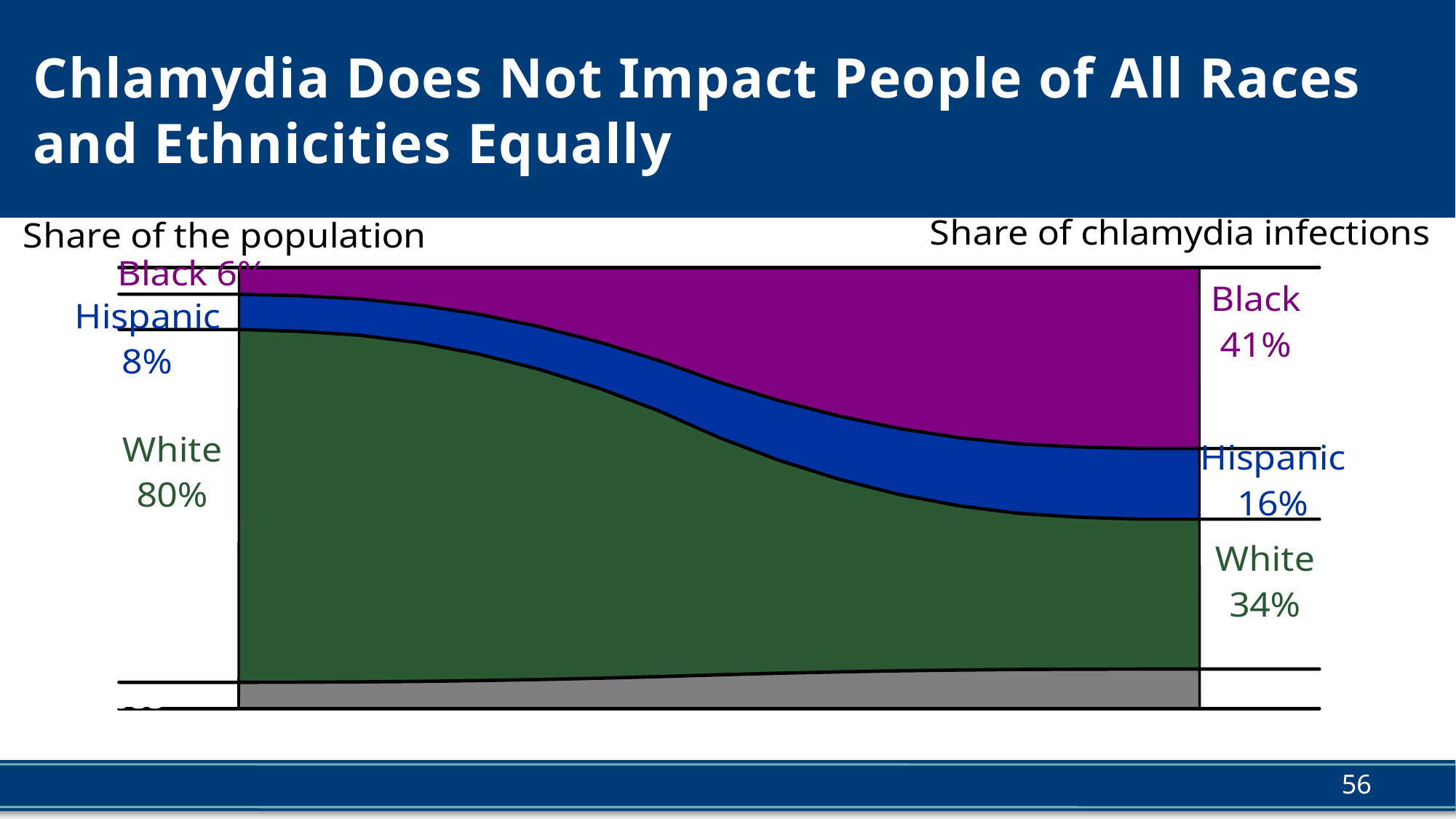
Is the White share larger for the population or for chlamydia infections? Population What is the label above the right side of the chart? Share of chlamydia infections Which labelled group has the largest share of the population? White What is the Hispanic share of chlamydia infections? 16% What is the Black share of chlamydia infections shown on the right side of the chart? 41% Does the White band rise or fall from the population side to the chlamydia infections side? Fall By how many percentage points does the Black share of chlamydia infections exceed the Black share of the population? 35 percentage points What is the White share of chlamydia infections? 34% Which labelled group has the largest share of chlamydia infections? Black What is the White share of the population shown on the left side of the chart? 80% What is the Black share of the population? 6% What is the Hispanic share of the population? 8%